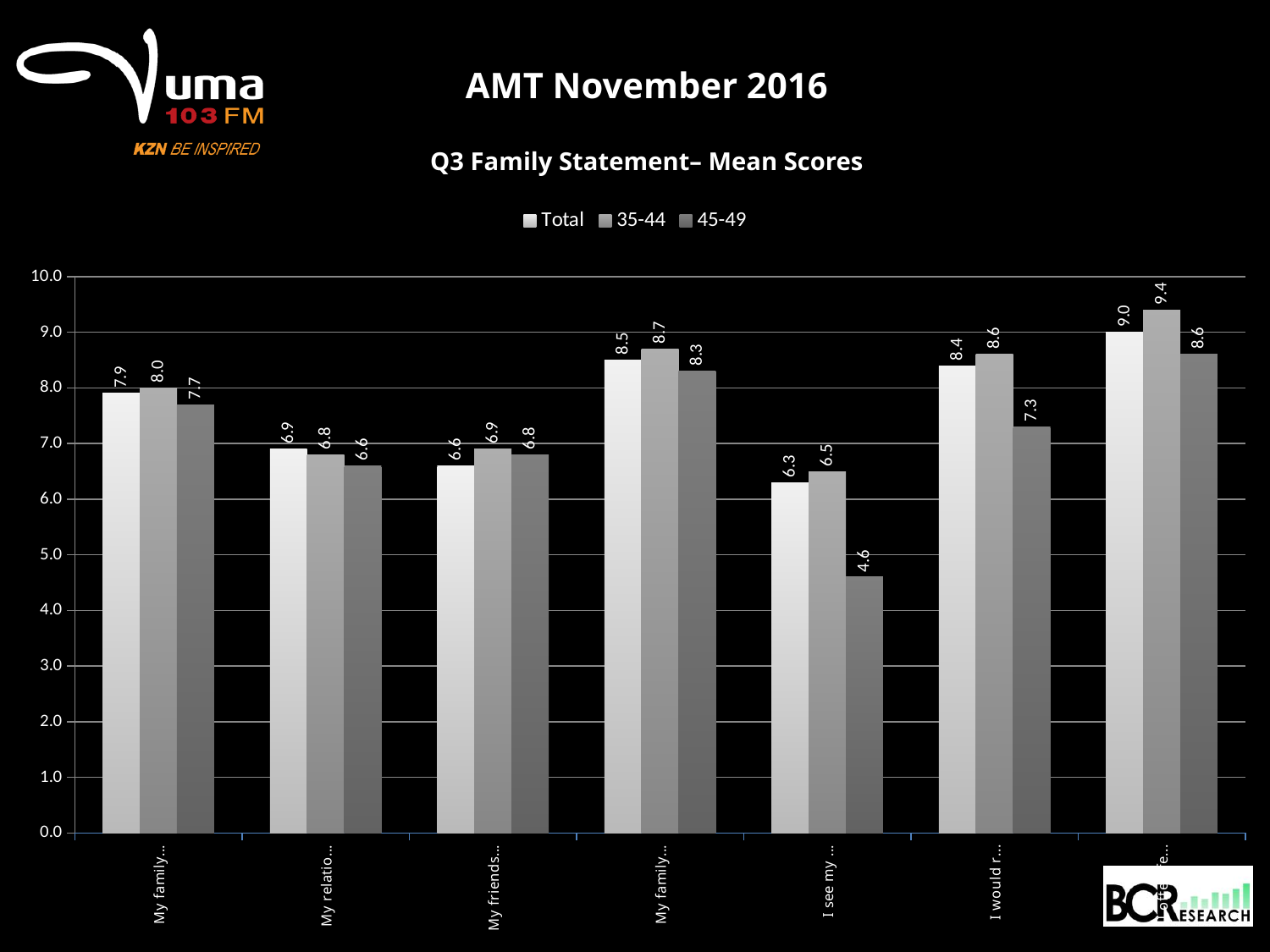
In the sixth category group ('I would r...'), which is larger: the Total value or the 45-49 value? Total (8.4) How many series does the legend list? 3 Which category group has the lowest 45-49 value? the fifth group ('I see my ...'), 4.6 What is the Total value for the first category group (leftmost)? 7.9 How many category groups are plotted along the x axis? 7 What is the title of the chart? Q3 Family Statement– Mean Scores Is the 45-49 value for the fourth category group greater or less than 8.0? greater What is the difference between the 35-44 value and the 45-49 value in the fifth category group ('I see my ...')? 1.9 What is the 35-44 value for the sixth category group, labelled 'I would r...'? 8.6 What kind of chart is shown on the slide? bar chart Which category group has the highest 35-44 value? the seventh (rightmost) group, 9.4 What is the 45-49 value for the fifth category group, labelled 'I see my ...'? 4.6